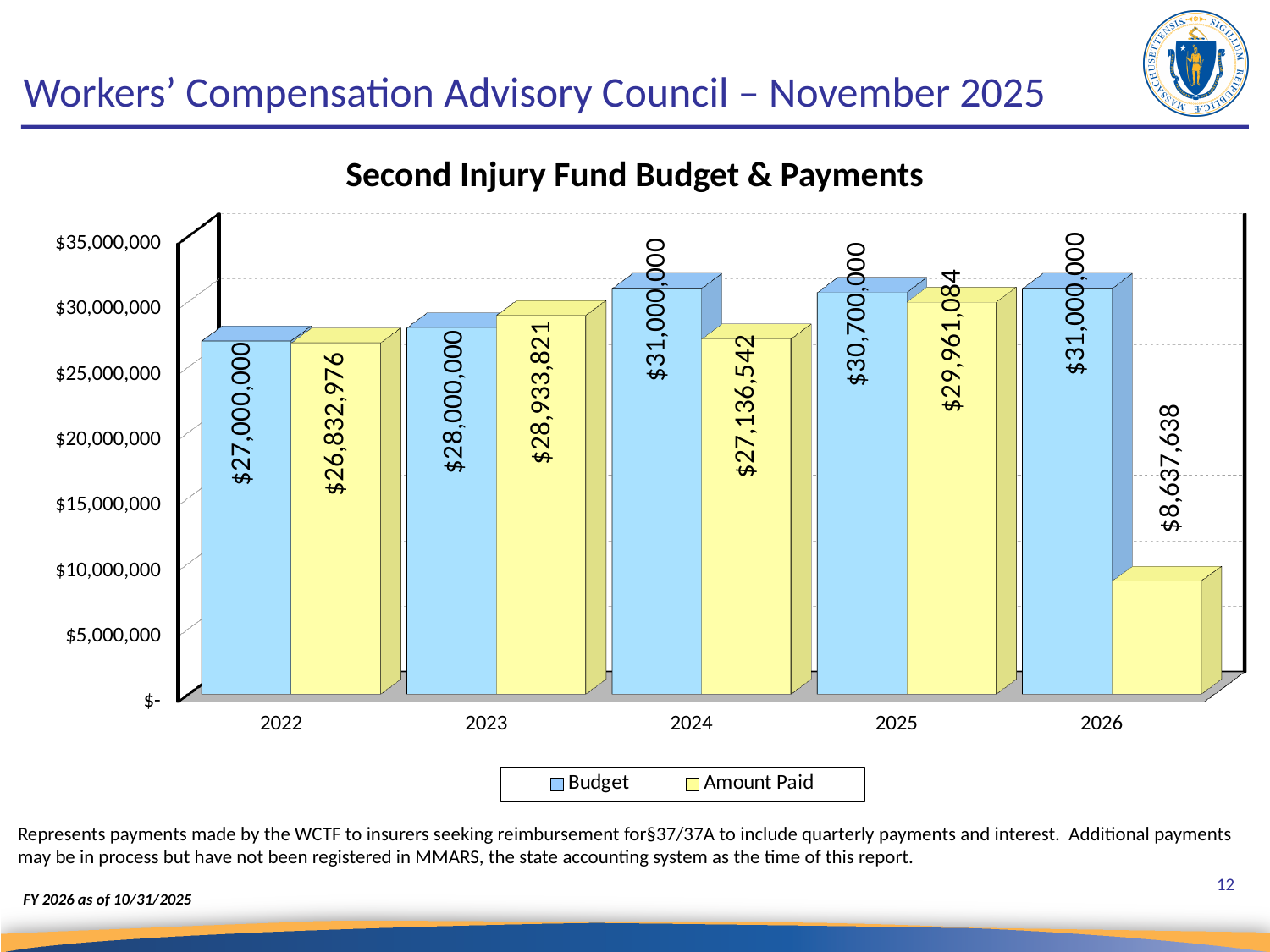
Is the Amount Paid for 2026 greater or less than $10,000,000? less What is the Amount Paid value for 2025? $29,961,084 How many years are shown on the x axis? 5 In 2023, which is larger, the Budget or the Amount Paid? Amount Paid What is the difference between the Budget and the Amount Paid in 2024? $3,863,458 Which year has the highest Amount Paid? 2025 What is the Budget value for 2025? $30,700,000 How many series does the legend list? 2 What is the Amount Paid value for 2026? $8,637,638 Which year has the lowest Budget? 2022 What is the Budget value for 2022? $27,000,000 What type of chart is shown on the slide? bar chart